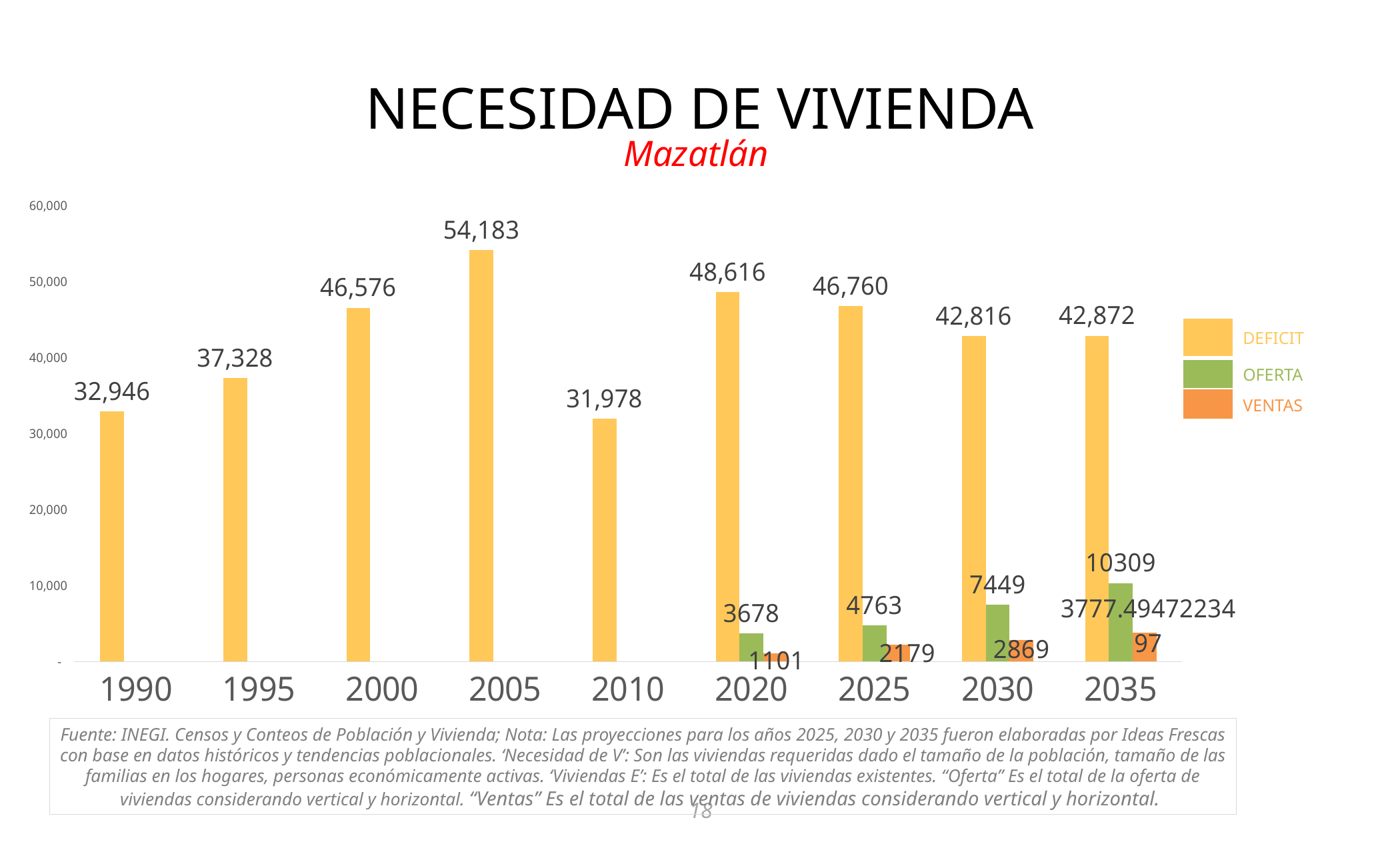
Is the DEFICIT value for 2000 greater or less than 40,000? greater What is the difference between the DEFICIT values for 2020 and 2025? 1,856 What is the OFERTA value for 2030? 7449 Do the OFERTA values rise or fall from 2020 to 2035? rise What kind of chart is shown on the slide? bar chart How many series does the legend list? 3 Which year has the lowest DEFICIT value? 2010 What is the VENTAS value for 2025? 2179 Which year has the highest DEFICIT value? 2005 Which is larger: the OFERTA value for 2035 or the VENTAS value for 2030? OFERTA for 2035 How many years are shown on the x axis? 9 What is the DEFICIT value for 2005? 54,183